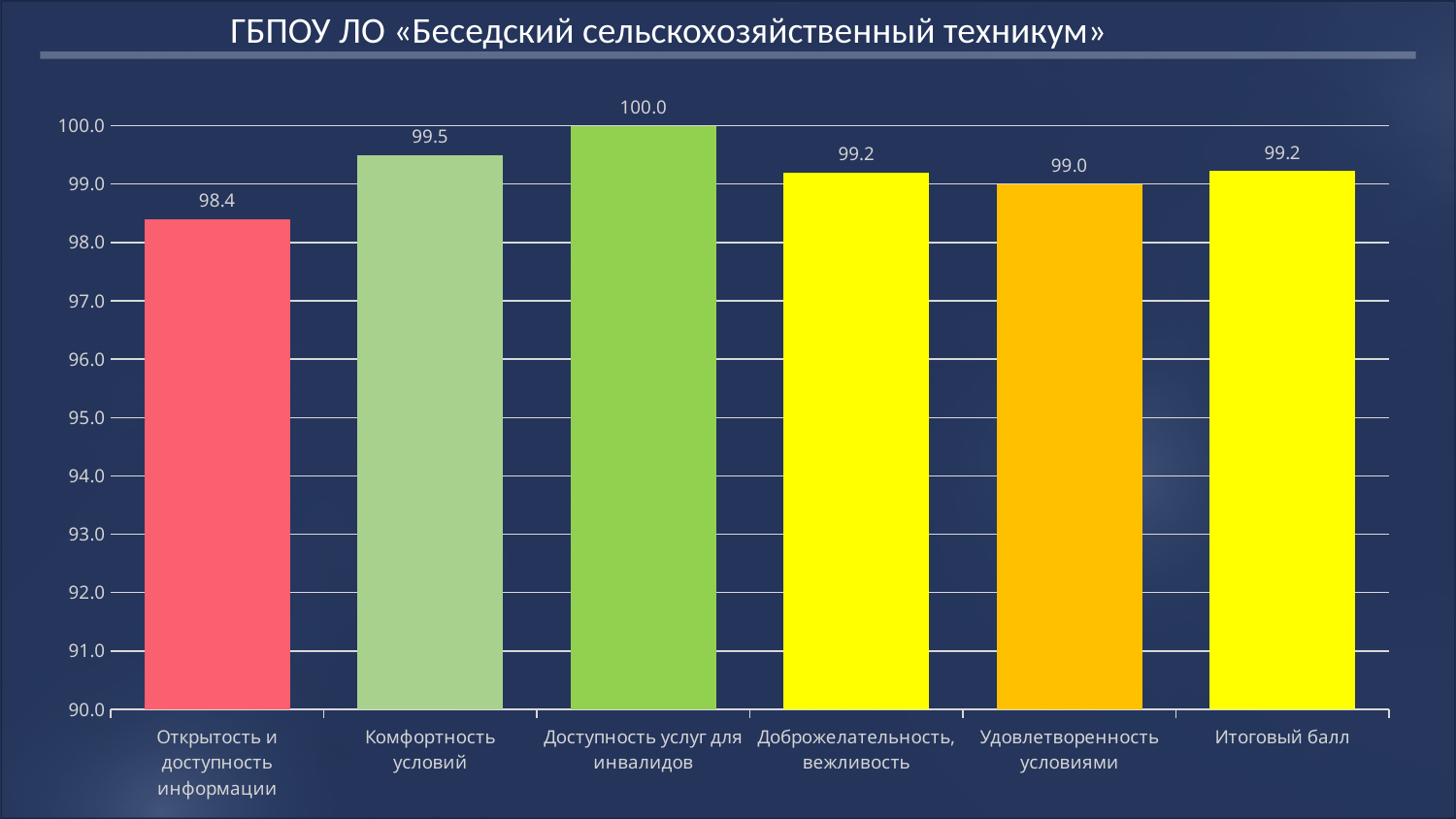
Which is larger: the value for «Комфортность условий» or the value for «Удовлетворенность условиями»? Комфортность условий What is the value for «Открытость и доступность информации»? 98.4 What is the value for «Доступность услуг для инвалидов»? 100.0 What is the difference between the values for «Доступность услуг для инвалидов» and «Открытость и доступность информации»? 1.6 Which category has the lowest value? Открытость и доступность информации Is the value for «Открытость и доступность информации» greater or less than 99.0? less What kind of chart is shown on the slide? bar chart What is the value for «Комфортность условий»? 99.5 What is the value for «Удовлетворенность условиями»? 99.0 How many categories are shown on the chart? 6 What is the value for «Итоговый балл»? 99.2 Which category has the highest value? Доступность услуг для инвалидов